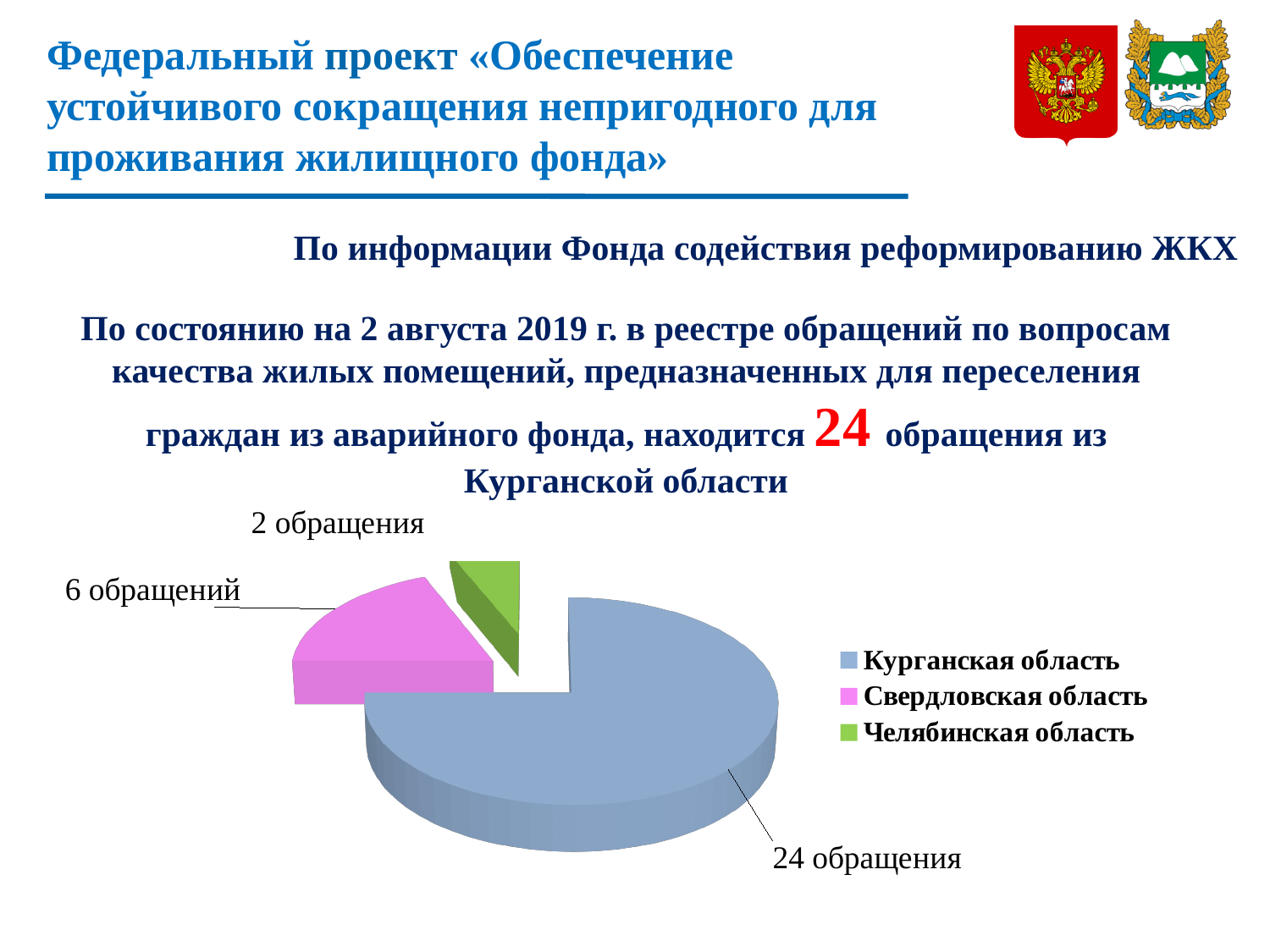
How many entries does the chart legend list? 3 Which colour represents Свердловская область in the pie chart? Pink How many обращения are shown for Челябинская область? 2 обращения How many обращений are shown for Свердловская область? 6 обращений Which region has the smallest slice of the pie? Челябинская область What is the difference between the number of обращения for Курганская область and Свердловская область? 18 What kind of chart is shown on the slide? Pie chart Which has more обращения: Свердловская область or Челябинская область? Свердловская область How many обращения are shown for Курганская область? 24 обращения Which region has the largest slice of the pie? Курганская область How many slices does the pie chart have? 3 What share of the pie does Курганская область represent? 75%